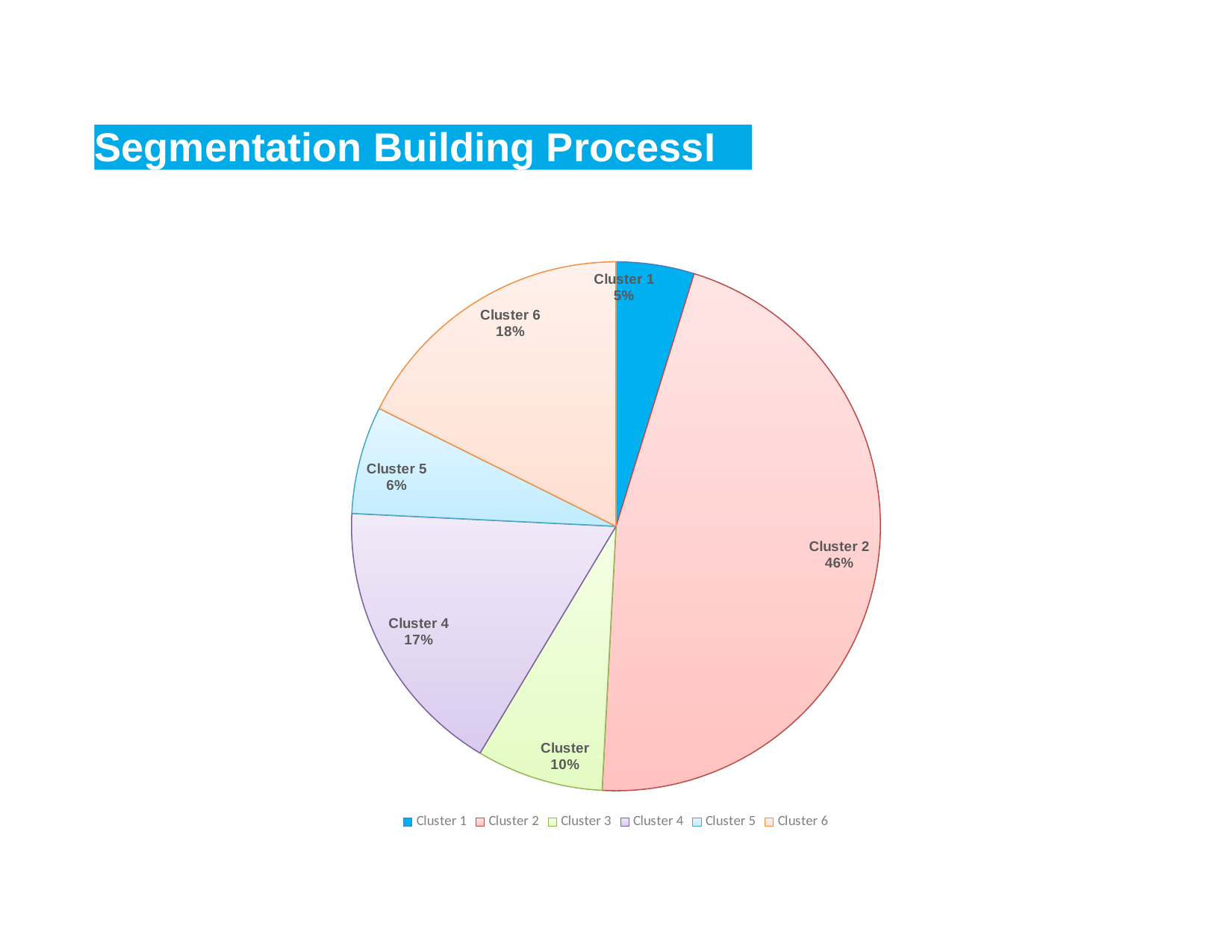
What is the difference in percentage points between Cluster 2 and Cluster 6? 28 What share of the pie does Cluster 5 represent? 6% What is the title shown at the top of the slide? Segmentation Building ProcessI What kind of chart is shown on the slide? pie chart What share of the pie does Cluster 2 represent? 46% What share of the pie does Cluster 6 represent? 18% How many clusters does the legend list? 6 Which cluster has the largest slice of the pie? Cluster 2 Which is larger, the share for Cluster 4 or the share for Cluster 5? Cluster 4 Which cluster has the smallest slice of the pie? Cluster 1